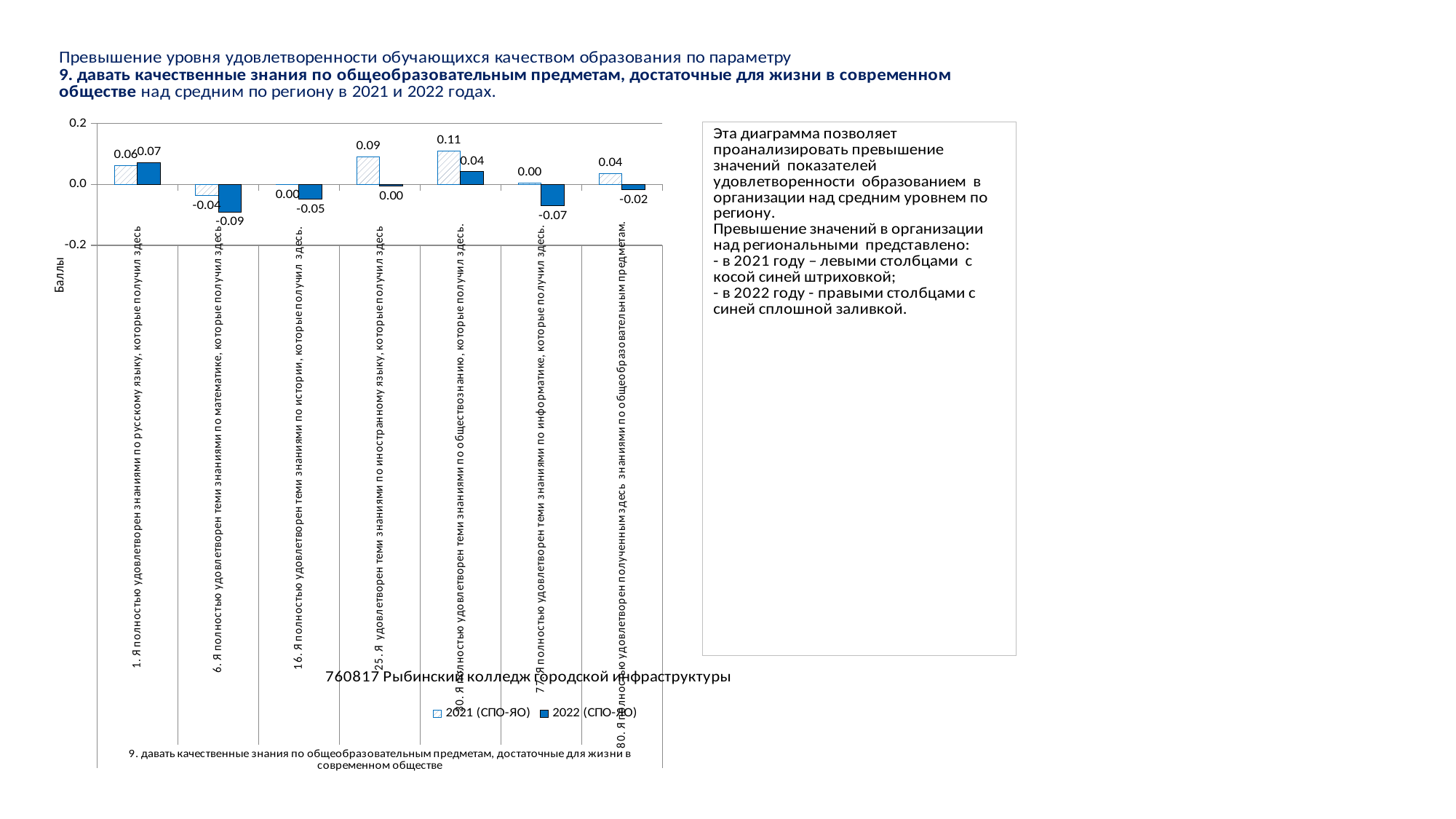
How many categories are shown on the x axis of the chart? 7 For the category about общеобразовательные предметы (item 80), which year has the larger value, 2021 or 2022? 2021 What type of chart is shown on the slide? Bar chart Which category has the highest 2021 (СПО-ЯО) value? 30. Я полностью удовлетворен теми знаниями по обществознанию, которые получил здесь What is the 2021 (СПО-ЯО) value for the category about knowledge of обществознание (item 30)? 0.11 What is the difference between the 2021 and 2022 values for the category about иностранный язык (item 25)? 0.09 What is the 2022 (СПО-ЯО) value for the category about knowledge of информатика (item 77)? -0.07 How many series does the chart legend list? 2 What is the 2021 (СПО-ЯО) value for the category about knowledge of русский язык (item 1)? 0.06 Which category has the lowest 2022 (СПО-ЯО) value? 6. Я полностью удовлетворен теми знаниями по математике, которые получил здесь What is the 2022 (СПО-ЯО) value for the category about knowledge of математика (item 6)? -0.09 What is the label of the vertical axis of the chart? Баллы